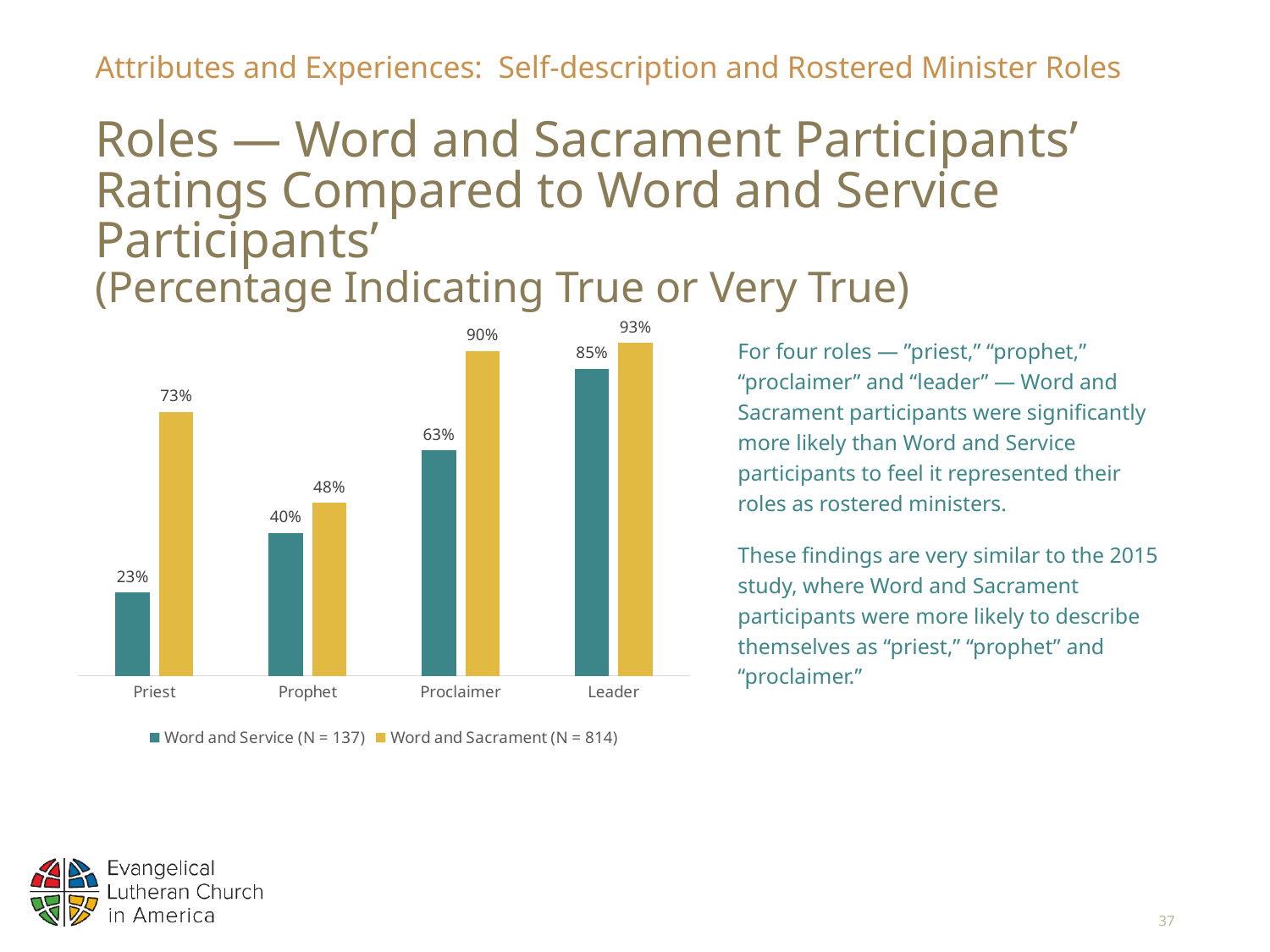
For the "Proclaimer" role, which group has the larger value: Word and Service or Word and Sacrament? Word and Sacrament How many series does the legend list? 2 How many roles are shown on the x axis of the chart? 4 What is the difference between the Word and Sacrament and Word and Service values for "Priest"? 50 percentage points Which role has the lowest value for Word and Service participants? Priest What is the value for Word and Service participants for the "Leader" role? 85% What percentage of Word and Service participants rated "Proclaimer" as true or very true? 63% What is the difference between the Word and Sacrament and Word and Service values for "Prophet"? 8 percentage points Which role has the highest value for Word and Sacrament participants? Leader What is the sample size (N) for the Word and Sacrament series shown in the legend? 814 What kind of chart is shown on the slide? Bar chart What percentage of Word and Sacrament participants rated "Priest" as true or very true? 73%